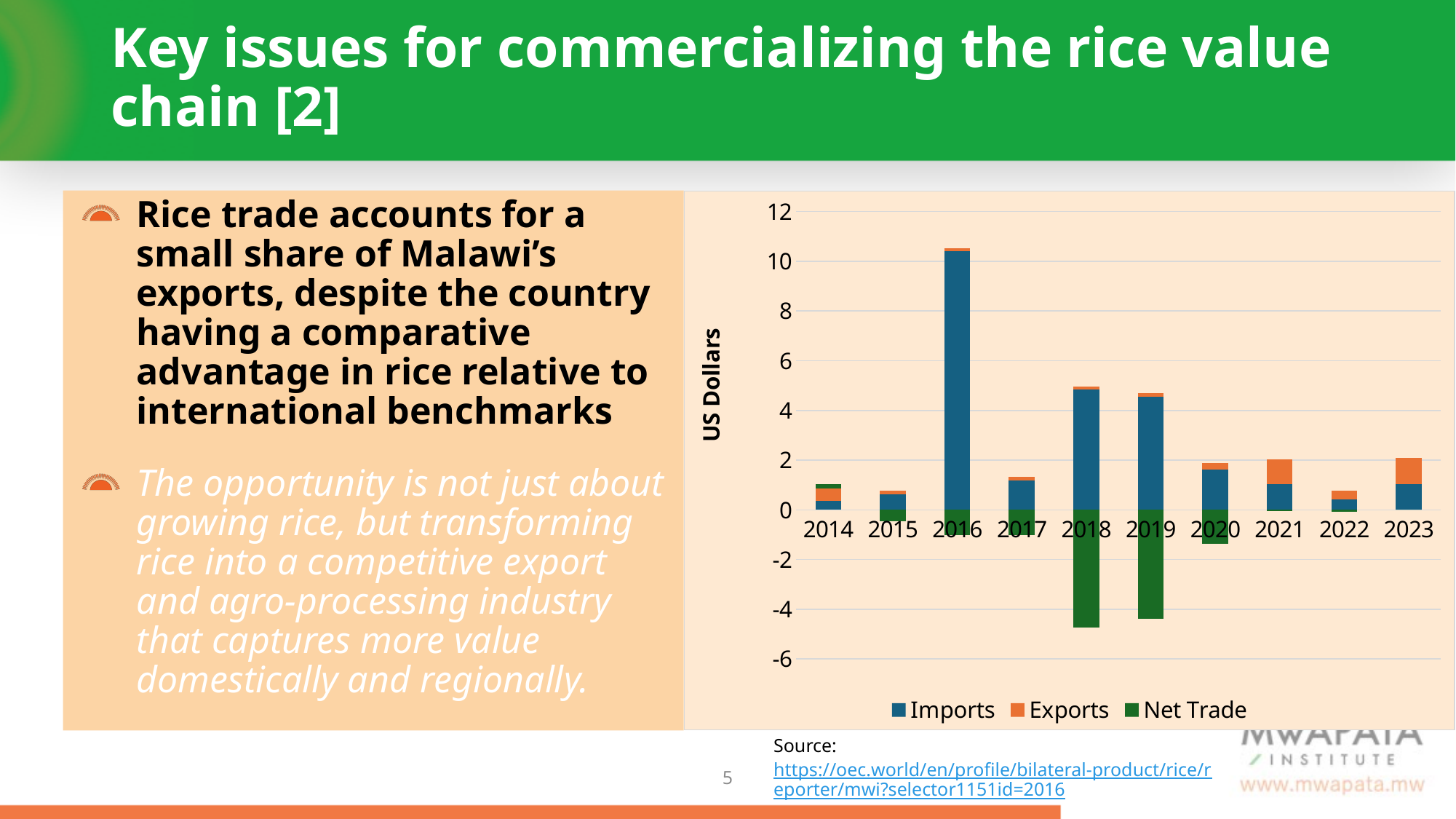
What are the three series listed in the chart's legend? Imports, Exports, Net Trade How many series does the chart's legend list? 3 Is the value for Net Trade in 2014 greater or less than 0? greater Do Imports rise or fall from 2016 to 2017? fall How many years are shown on the x axis of the chart? 10 Is the value for Net Trade in 2018 greater or less than -4? less Which year has larger Imports, 2016 or 2018? 2016 What kind of chart is shown on the slide? bar chart Is the value for Imports in 2016 greater or less than 8? greater In which year are Imports highest? 2016 What is the label on the vertical axis of the chart? US Dollars